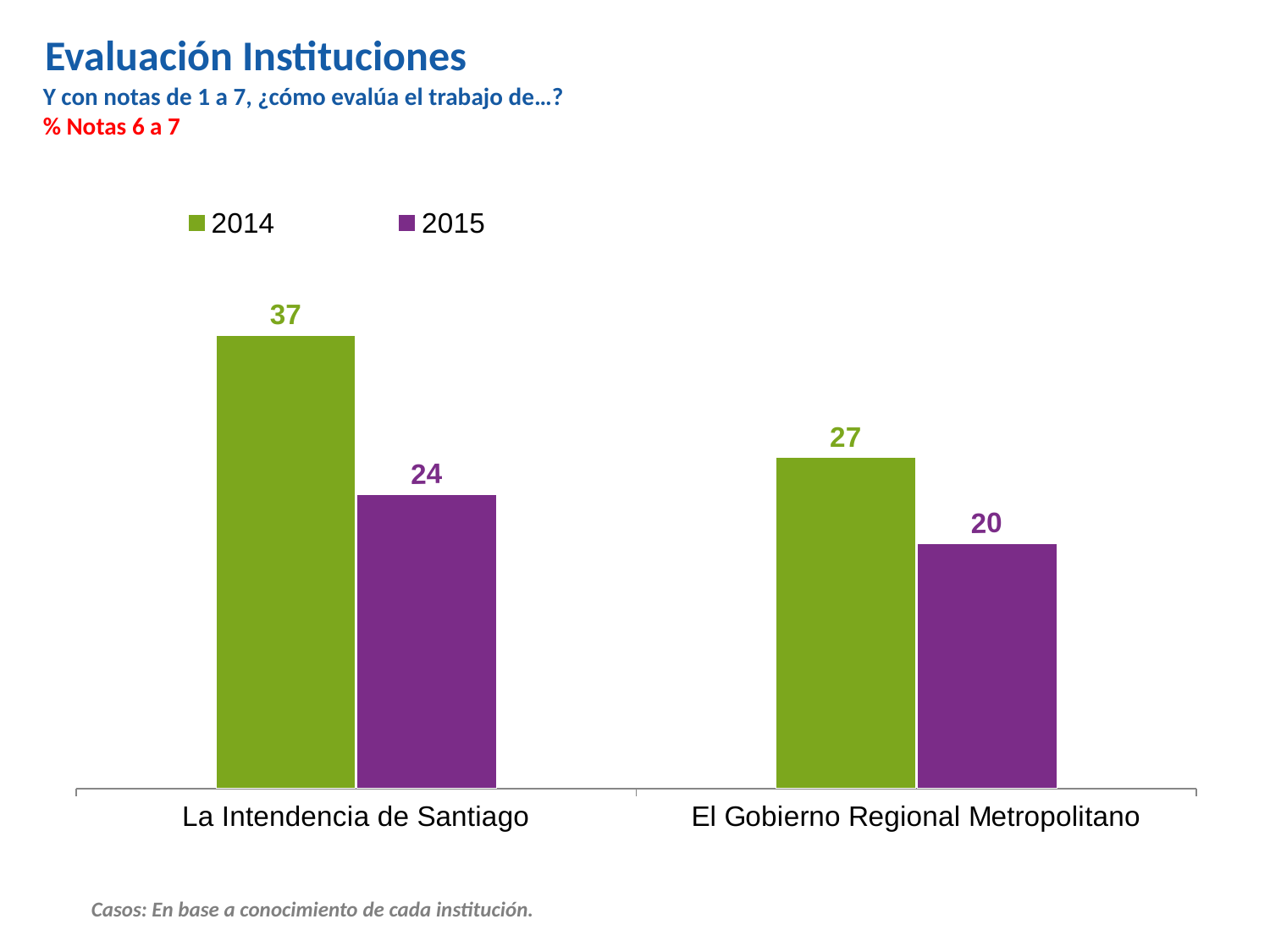
What is the 2015 value for El Gobierno Regional Metropolitano? 20 What is the 2015 value for La Intendencia de Santiago? 24 Which colour represents the 2015 series? Purple What is the difference between the 2014 and 2015 values for La Intendencia de Santiago? 13 Which is larger: the 2015 value for La Intendencia de Santiago or the 2014 value for El Gobierno Regional Metropolitano? 2014 value for El Gobierno Regional Metropolitano What is the 2014 value for La Intendencia de Santiago? 37 How many series does the legend list? 2 Which category has the lowest 2015 value? El Gobierno Regional Metropolitano What kind of chart is shown on the slide? Bar chart What is the difference between the 2014 values for La Intendencia de Santiago and El Gobierno Regional Metropolitano? 10 How many categories are shown on the x axis? 2 Which category has the highest 2014 value? La Intendencia de Santiago